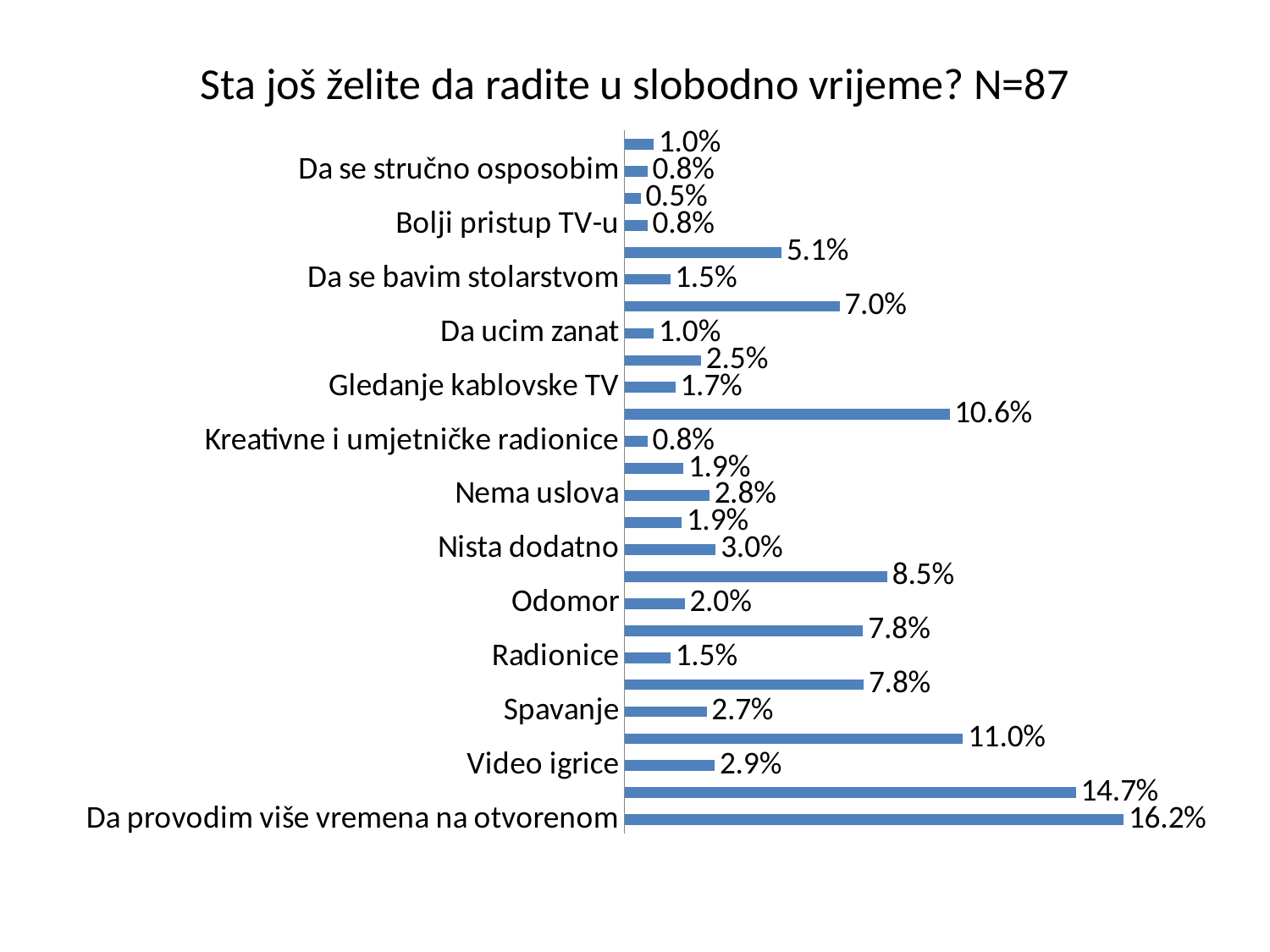
What is the value for "Nista dodatno"? 3.0% Which labeled category has the highest value? Da provodim više vremena na otvorenom What is the value for "Da se bavim stolarstvom"? 1.5% What is the difference between the values for "Spavanje" and "Radionice"? 1.2% What is the title of the chart? Sta još želite da radite u slobodno vrijeme? N=87 What is the difference between the values for "Da provodim više vremena na otvorenom" and "Video igrice"? 13.3% What is the value for "Da provodim više vremena na otvorenom"? 16.2% Which is larger, the value for "Nema uslova" or the value for "Odomor"? Nema uslova What is the value for "Gledanje kablovske TV"? 1.7% What kind of chart is shown on the slide? bar chart What is the smallest value shown on any bar in the chart? 0.5% What is the value for "Video igrice"? 2.9%